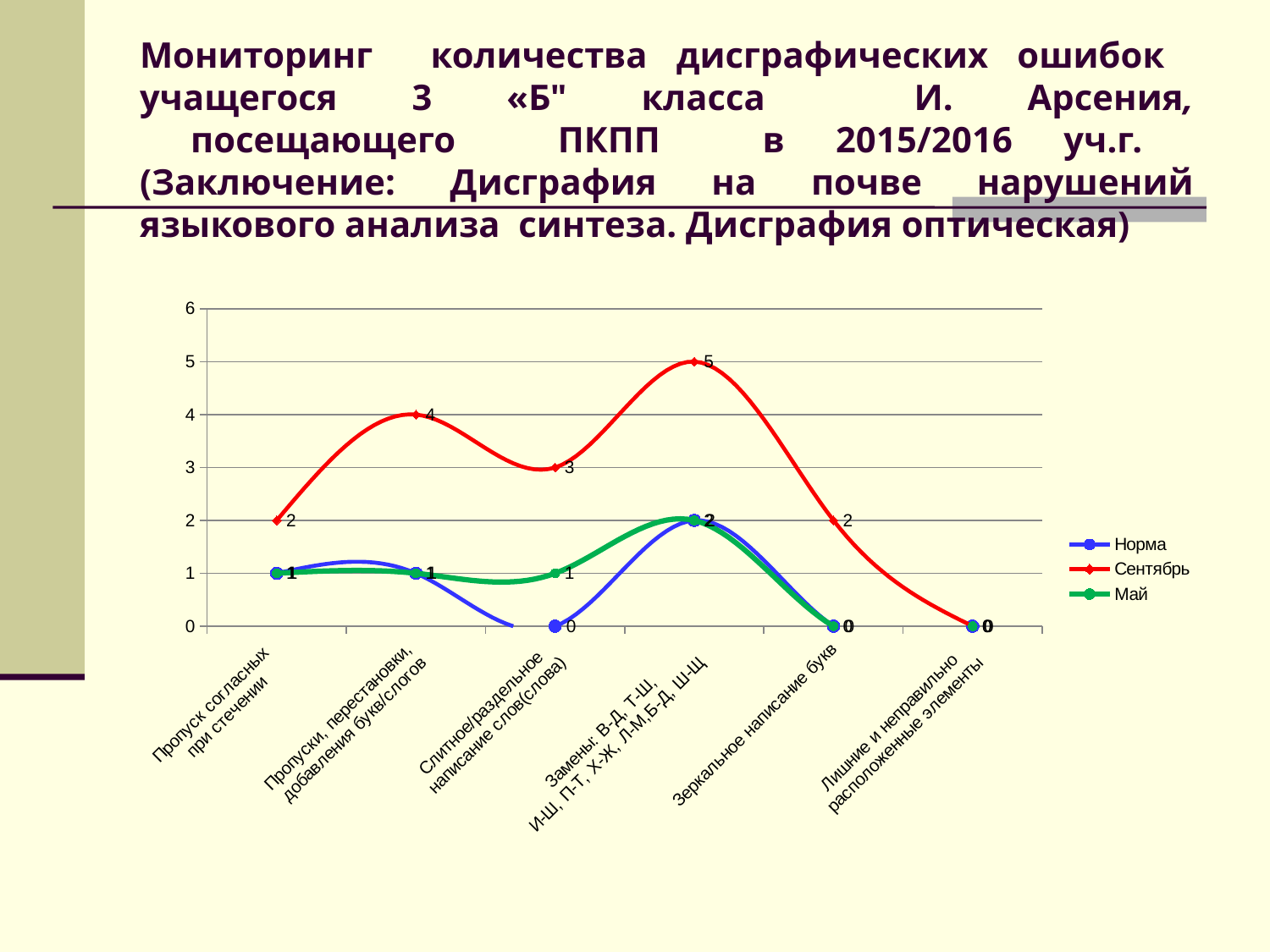
What is the difference between the Сентябрь and Май values for the category 'Замены: В-Д, Т-Ш, И-Ш, П-Т, Х-Ж, Л-М,Б-Д, Ш-Щ'? 3 What is the value of the Сентябрь series for 'Лишние и неправильно расположенные элементы'? 0 How many categories are shown on the x axis? 6 What is the value of the Сентябрь series for 'Пропуски, перестановки, добавления букв/слогов'? 4 What kind of chart is shown on the slide? line chart For which category does the Сентябрь series reach its highest value? Замены: В-Д, Т-Ш, И-Ш, П-Т, Х-Ж, Л-М,Б-Д, Ш-Щ What is the value of the Норма series for 'Слитное/раздельное написание слов(слова)'? 0 What is the value of the Май series for 'Слитное/раздельное написание слов(слова)'? 1 For the Сентябрь series, which is larger: the value for 'Пропуск согласных при стечении' or for 'Слитное/раздельное написание слов(слова)'? Слитное/раздельное написание слов(слова) How many series does the legend list? 3 Which series is drawn in red? Сентябрь What is the value of the Сентябрь series for the category 'Замены: В-Д, Т-Ш, И-Ш, П-Т, Х-Ж, Л-М,Б-Д, Ш-Щ'? 5